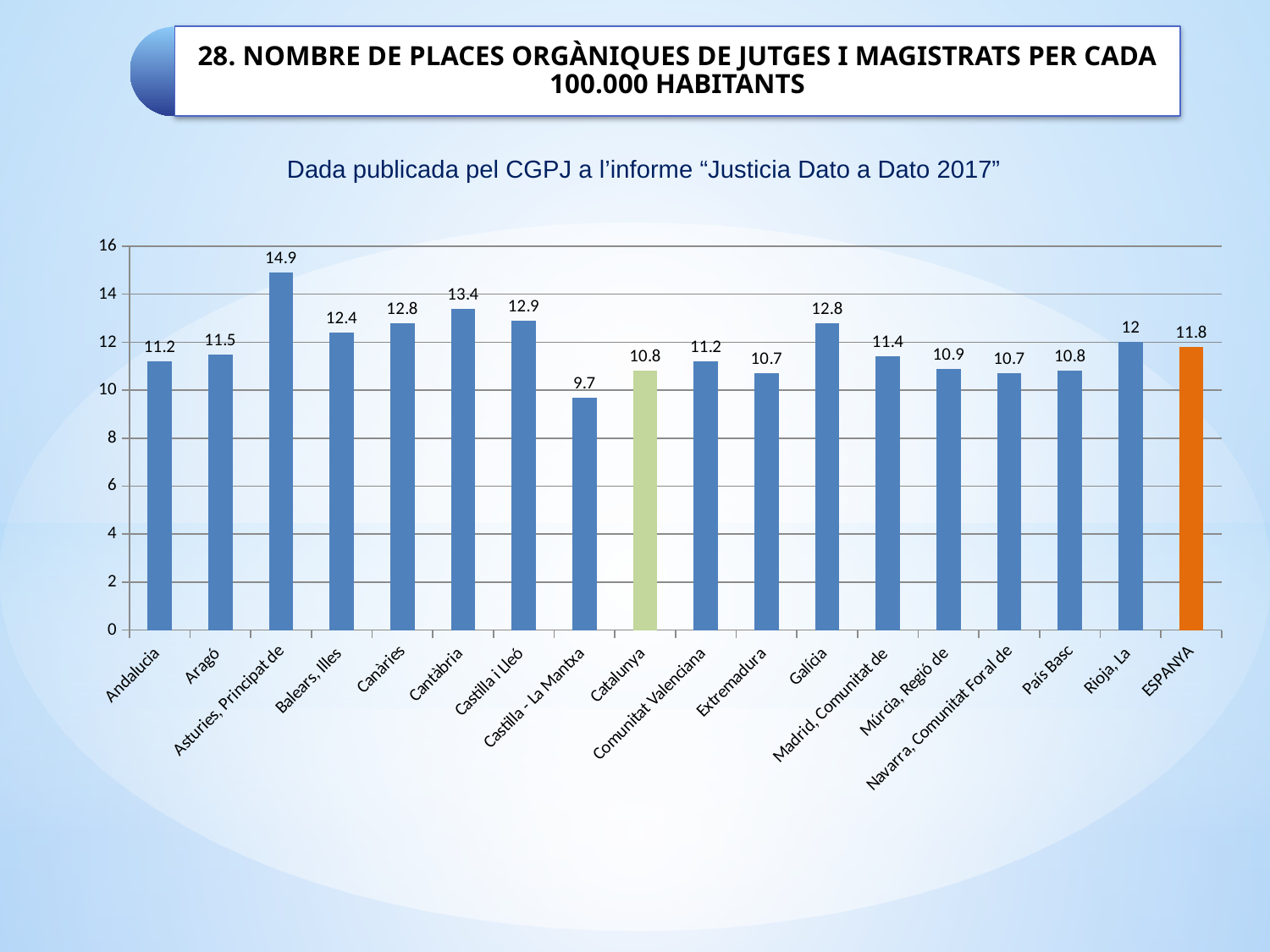
What is the difference between the value for ESPANYA and the value for Catalunya? 1 Which category has the highest value? Asturies, Principat de Which is larger, the value for Galícia or the value for Madrid, Comunitat de? Galícia What is the value for Catalunya? 10.8 What kind of chart is shown on the slide? Bar chart What is the value for ESPANYA? 11.8 Which category has the lowest value? Castilla - La Mantxa Which bar is coloured orange? ESPANYA What is the value for Cantàbria? 13.4 How many categories are shown on the x axis? 18 What is the difference between the value for Asturies, Principat de and the value for Castilla - La Mantxa? 5.2 Is the value for Rioja, La greater or less than 10? greater